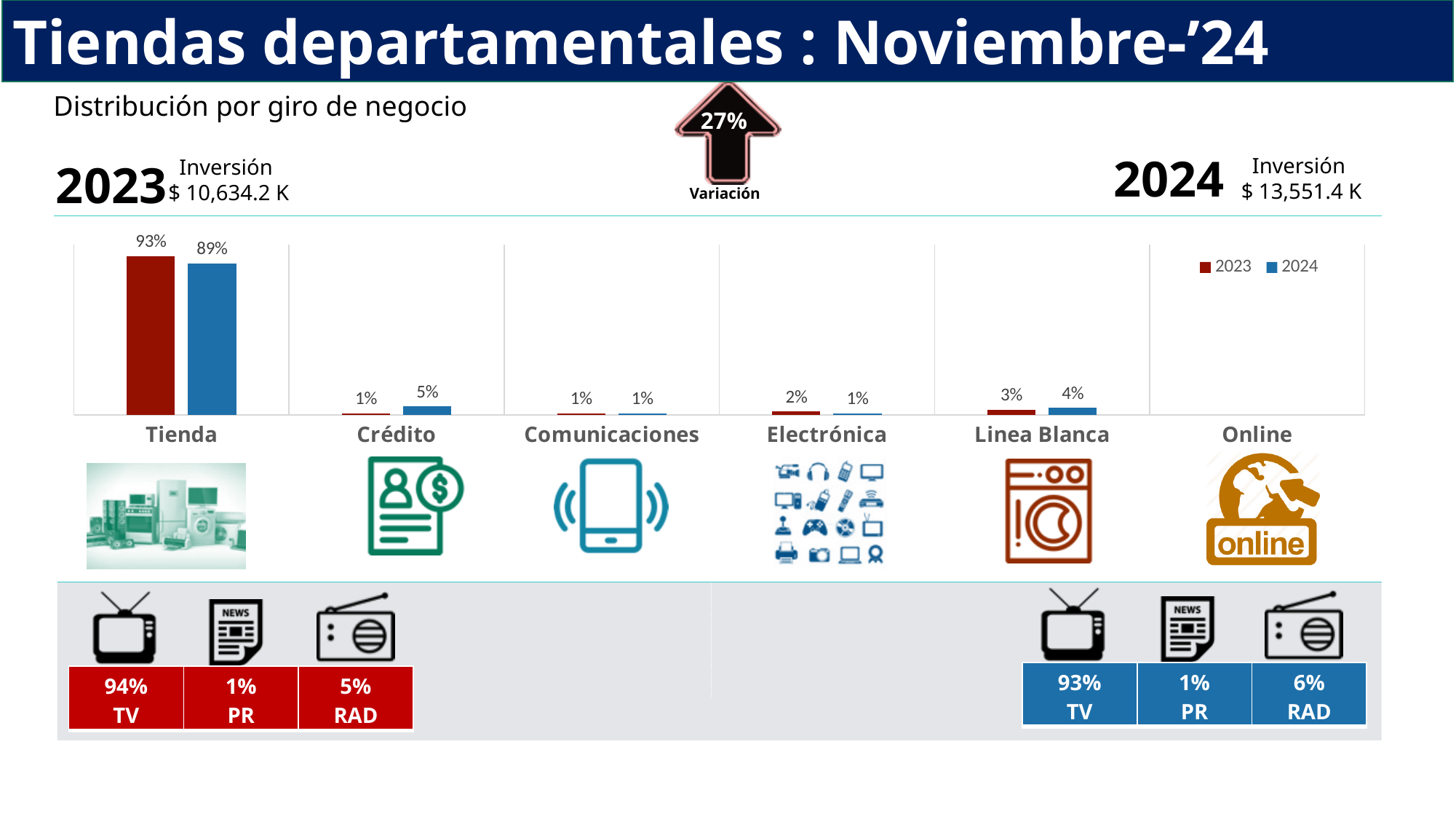
What is the difference between the 2023 and 2024 values for Tienda? 4% What is the difference between the 2024 and 2023 values for Crédito? 4% What is the 2024 value for Tienda in the bar chart? 89% How many categories are shown on the x axis of the bar chart? 6 For Linea Blanca, which year has the larger value, 2023 or 2024? 2024 What is the 2024 value for Crédito in the bar chart? 5% What kind of chart is shown on the slide? Bar chart What is the 2023 value for Linea Blanca in the bar chart? 3% What is the 2023 value for Tienda in the bar chart? 93% For Electrónica, which year has the larger value, 2023 or 2024? 2023 Which category has the highest 2024 value in the bar chart? Tienda How many series does the chart legend list? 2